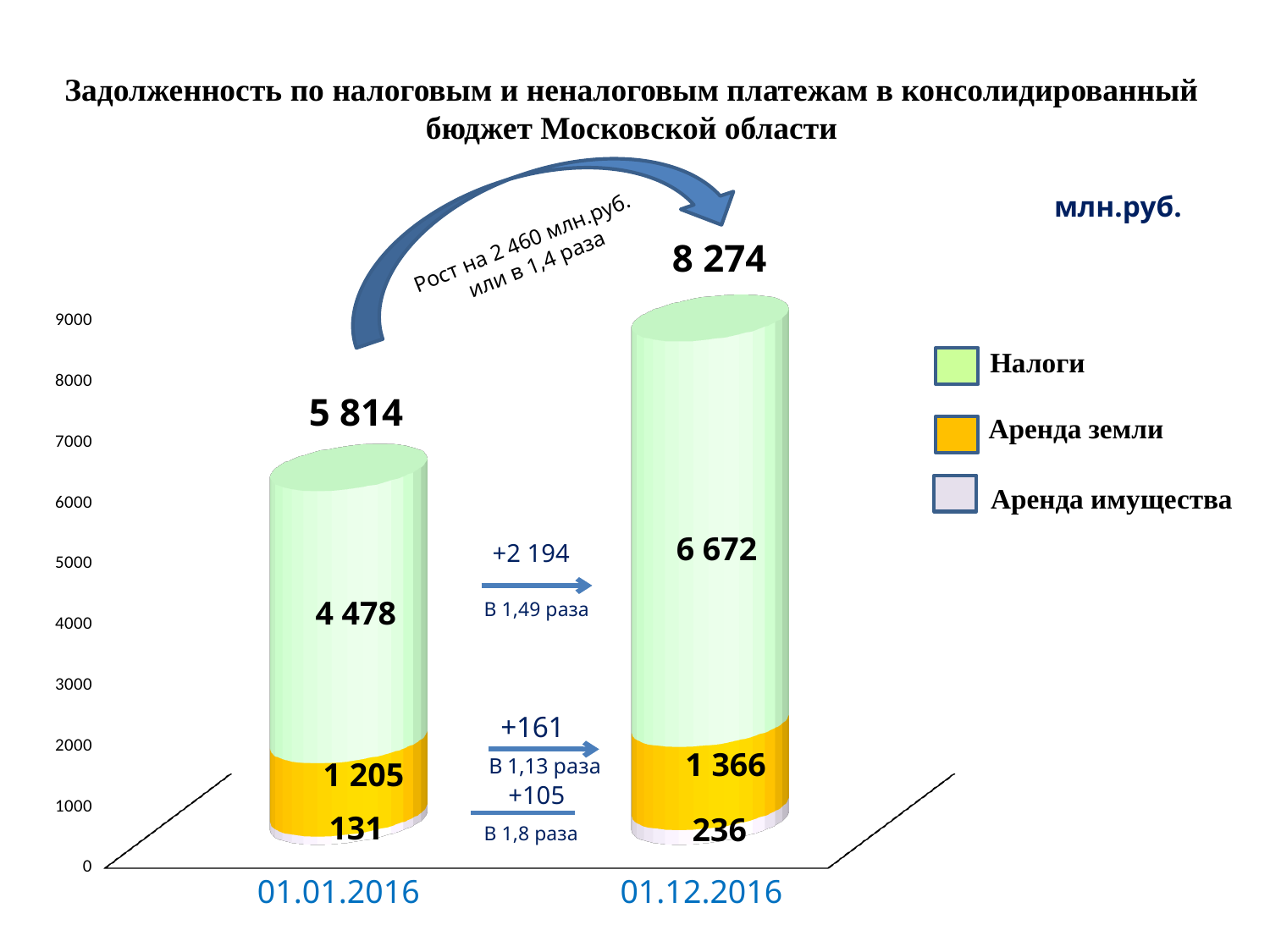
How many categories are shown on the x axis? 2 What is the difference between the Аренда имущества values for 01.12.2016 and 01.01.2016? 105 What is the total of the stacked bar for 01.01.2016? 5 814 What is the total of the stacked bar for 01.12.2016? 8 274 What is the value of Аренда земли for 01.01.2016? 1 205 Which series has the lowest value for 01.01.2016? Аренда имущества What is the value of Налоги for 01.12.2016? 6 672 What kind of chart is shown on the slide? Stacked bar chart Which date has the higher value for Аренда земли, 01.01.2016 or 01.12.2016? 01.12.2016 What is the difference between the Налоги values for 01.12.2016 and 01.01.2016? 2 194 What is the value of Аренда имущества for 01.12.2016? 236 How many series does the legend list? 3